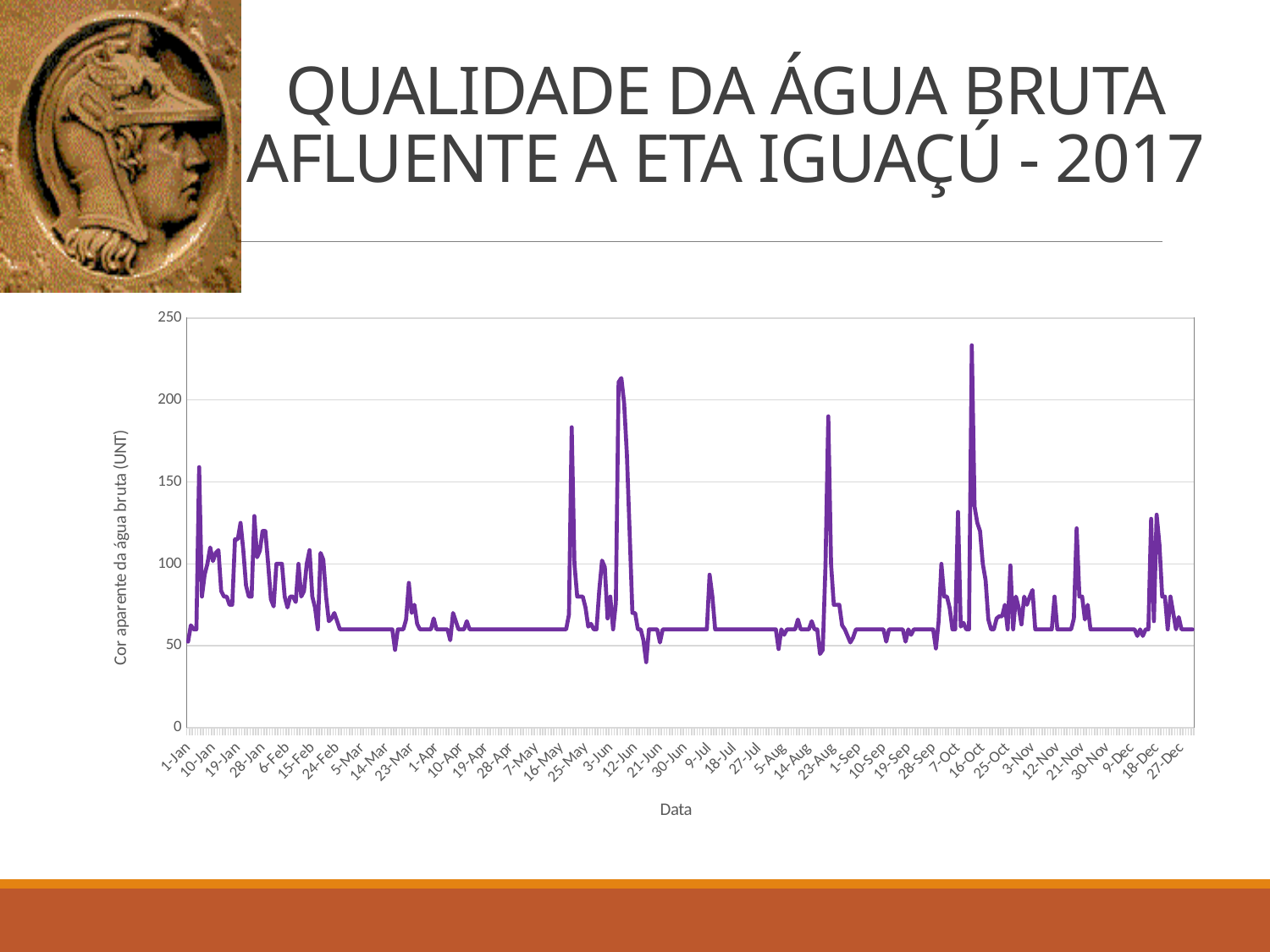
What is the label of the vertical axis of the chart? Cor aparente da água bruta (UNT) Is the peak of the line near 23-Aug greater or less than 150? greater Is the highest peak of the line, near 16-Oct, greater or less than 200? greater Is the value of the line around 5-Mar greater or less than 100? less What is the highest value shown on the vertical axis of the chart? 250 What is the label of the horizontal axis of the chart? Data What kind of chart is shown on the slide? line chart Which peak is higher: the one near 12-Jun or the one near 16-May? 12-Jun Around which date does the line reach its highest peak? 16-Oct